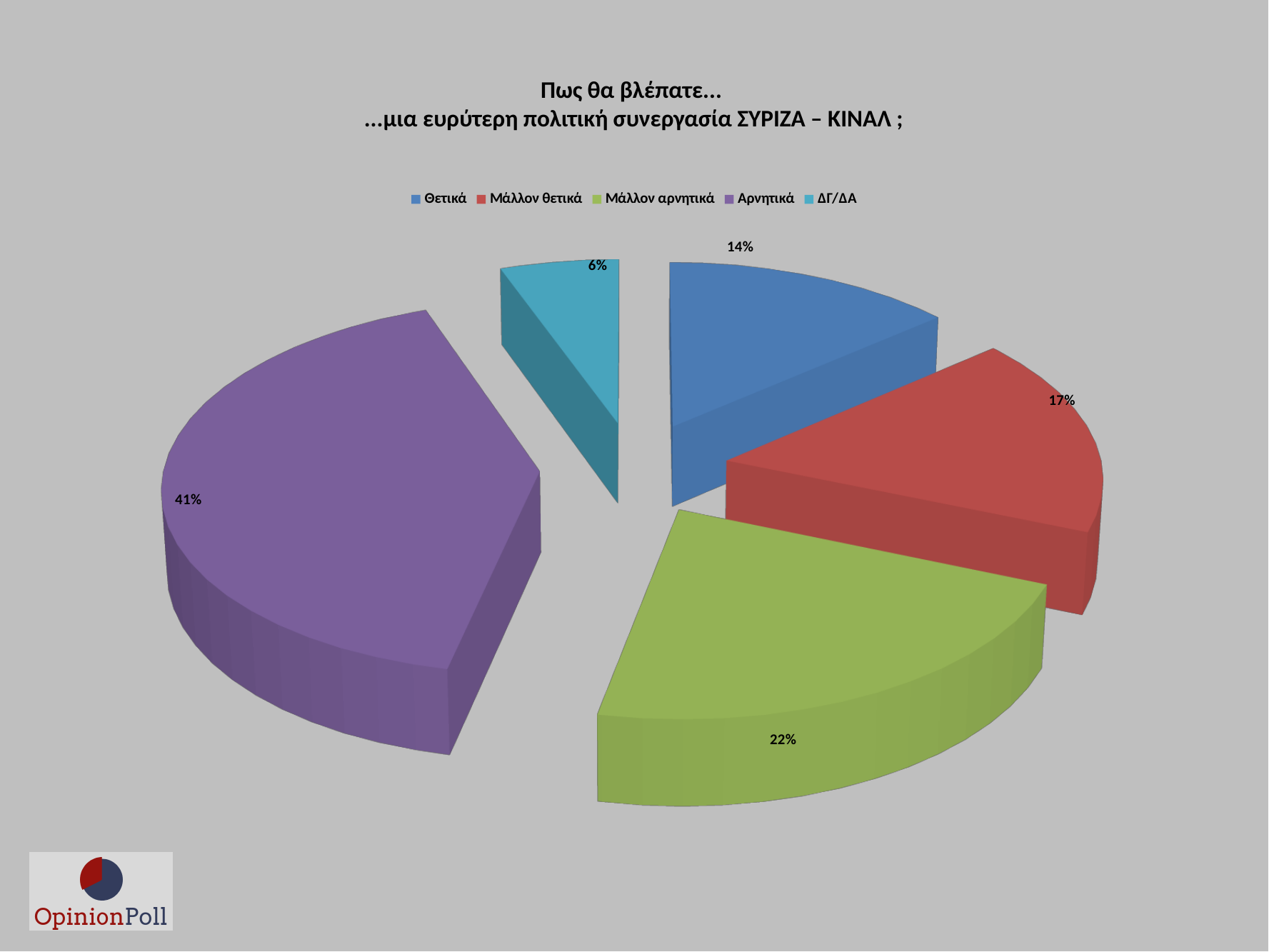
Which response has the largest share of the pie? Αρνητικά What percentage of respondents answered Θετικά? 14% What percentage of respondents answered Μάλλον θετικά? 17% What type of chart is shown on the slide? Pie chart Which is larger, the share for Θετικά or the share for Μάλλον θετικά? Μάλλον θετικά What is the difference in percentage points between Αρνητικά and Μάλλον αρνητικά? 19 Which response has the smallest share of the pie? ΔΓ/ΔΑ What percentage of respondents answered Αρνητικά? 41% What percentage of respondents answered ΔΓ/ΔΑ? 6% How many categories does the pie chart show? 5 What colour is the slice for Αρνητικά? Purple What percentage of respondents answered Μάλλον αρνητικά? 22%